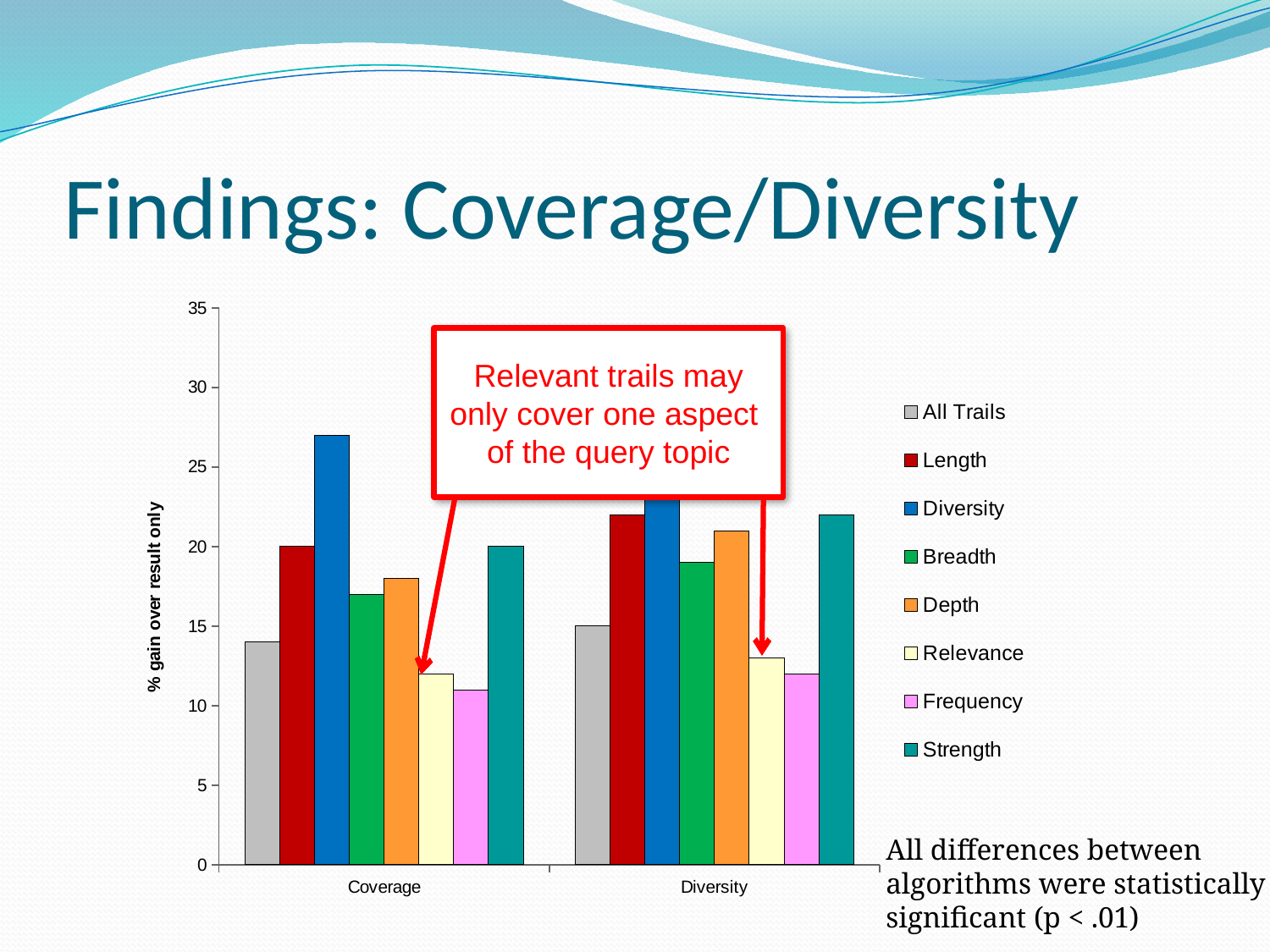
Is the value for Depth in the Diversity category greater or less than 20? greater What is the label on the vertical axis? % gain over result only Is the value for Frequency in the Coverage category greater or less than 15? less How many series does the legend list? 8 Which is larger: the Depth value for Coverage or for Diversity? Diversity How many categories are shown on the x axis? 2 Is the value for Breadth in the Coverage category greater or less than 15? greater What kind of chart is shown on the slide? bar chart Which series has the highest value in the Coverage category? Diversity